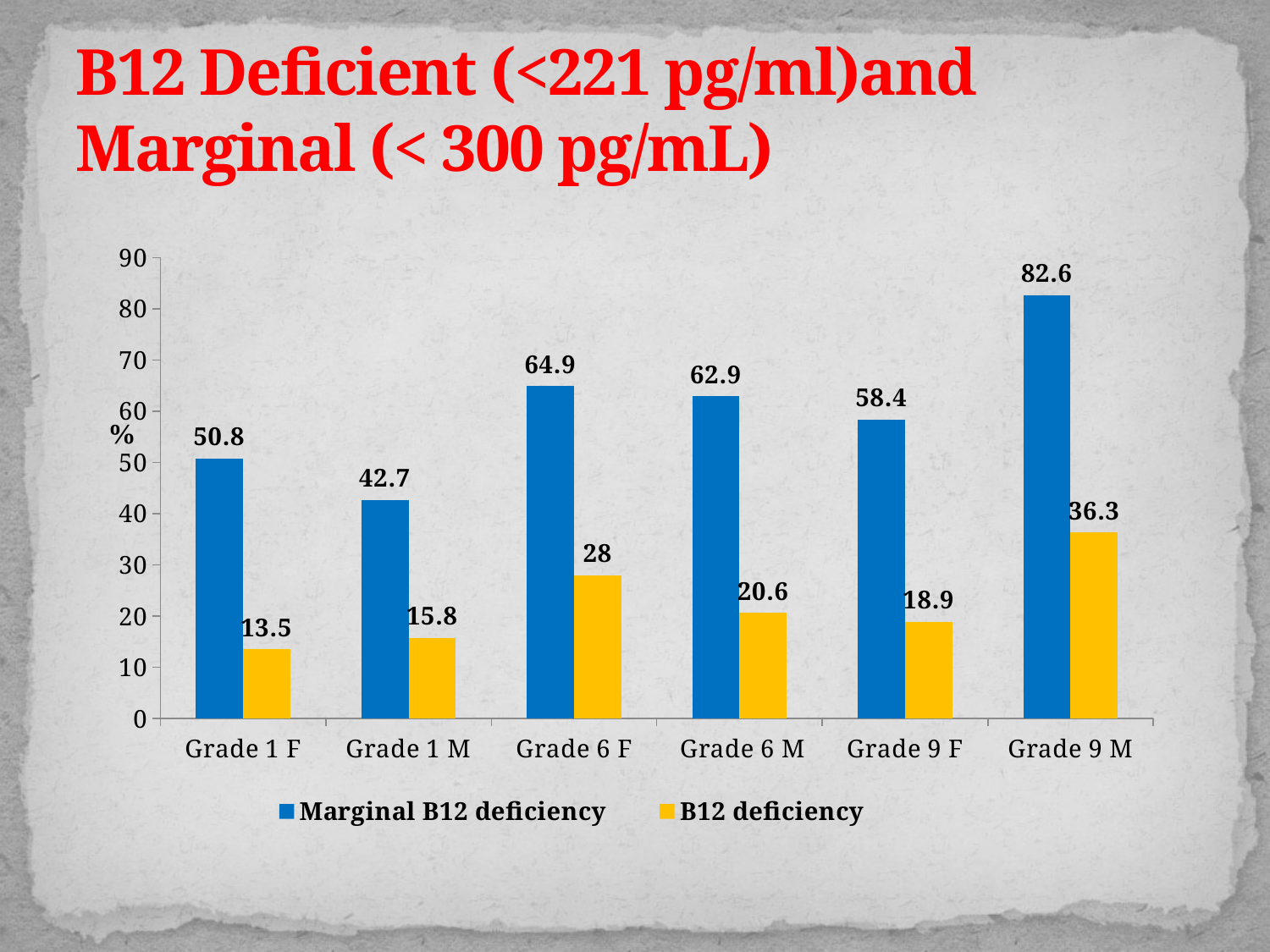
Which category has the lowest B12 deficiency value? Grade 1 F What kind of chart is shown on the slide? Bar chart What is the Marginal B12 deficiency value for Grade 1 M? 42.7 What colour are the bars for the B12 deficiency series? Yellow What is the difference between the Marginal B12 deficiency and B12 deficiency values for Grade 9 M? 46.3 Which is larger, the Marginal B12 deficiency value for Grade 6 F or for Grade 6 M? Grade 6 F Which category has the lowest Marginal B12 deficiency value? Grade 1 M What is the B12 deficiency value for Grade 6 F? 28 How many categories are shown on the x axis? 6 How many series does the legend list? 2 What is the Marginal B12 deficiency value for Grade 9 M? 82.6 Which category has the highest B12 deficiency value? Grade 9 M